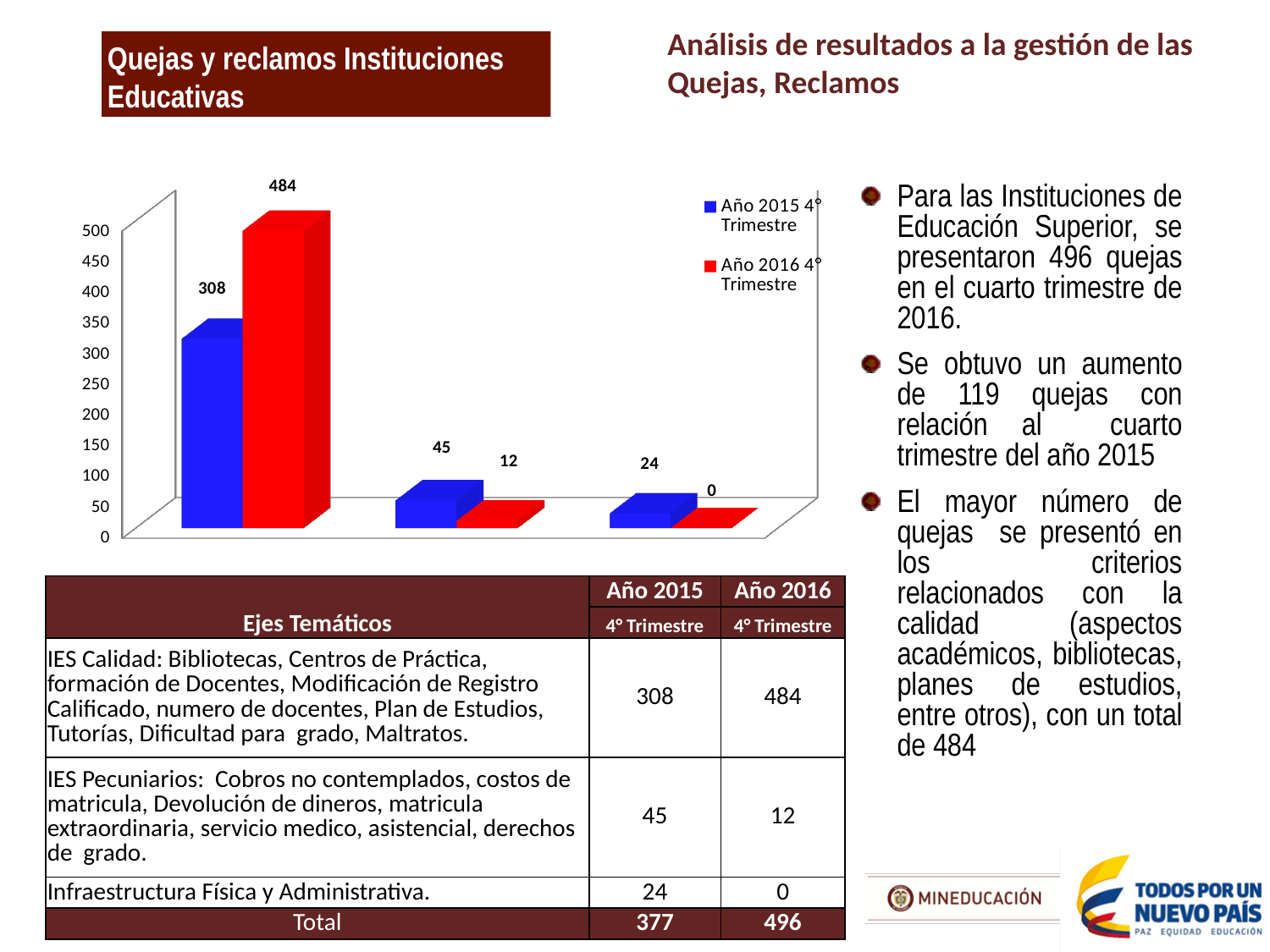
What is the value of the Año 2016 4° Trimestre bar in the third group of bars? 0 What is the value of the blue bar (Año 2015 4° Trimestre) in the first group of bars? 308 What type of chart is shown on the slide? bar chart What is the difference between the Año 2016 and Año 2015 values in the first group of bars? 176 Which colour represents the Año 2016 4° Trimestre series in the chart? red What is the value of the red bar (Año 2016 4° Trimestre) in the first group of bars? 484 In the second group of bars, which is larger: the Año 2015 4° Trimestre value or the Año 2016 4° Trimestre value? Año 2015 4° Trimestre What is the difference between the Año 2015 values in the second and third groups of bars? 21 What is the value of the Año 2015 4° Trimestre bar in the second group of bars? 45 How many series does the chart legend list? 2 Which series has the highest value in the chart? Año 2016 4° Trimestre How many groups of bars are plotted in the chart? 3